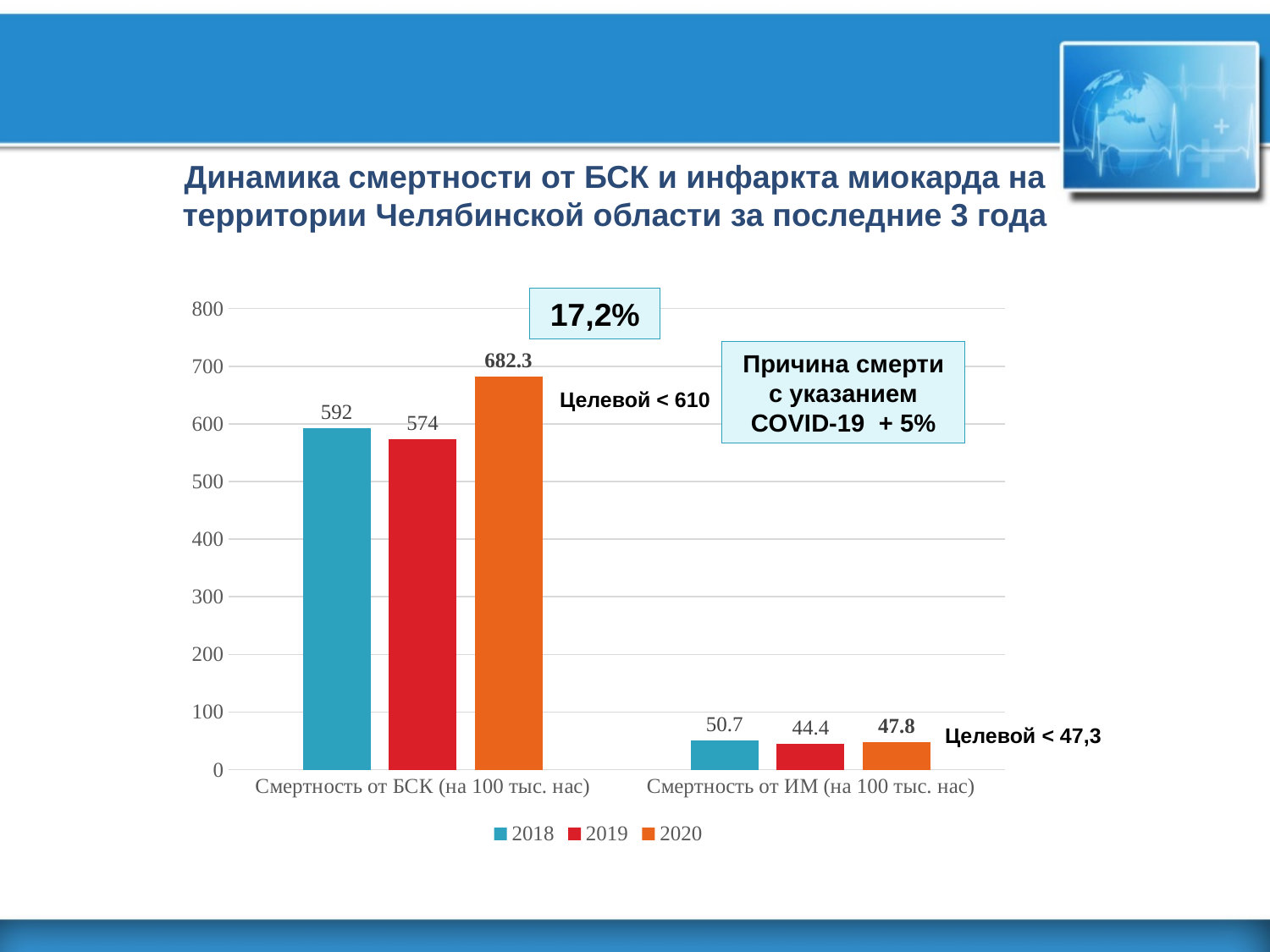
What is the difference between the 2020 and 2019 values in the category "Смертность от БСК (на 100 тыс. нас)"? 108.3 What is the difference between the 2018 and 2020 values in the category "Смертность от ИМ (на 100 тыс. нас)"? 2.9 Which year has the lowest value in the category "Смертность от ИМ (на 100 тыс. нас)"? 2019 What is the value for 2018 in the category "Смертность от БСК (на 100 тыс. нас)"? 592 What is the value for 2020 in the category "Смертность от БСК (на 100 тыс. нас)"? 682.3 Is the 2020 value for "Смертность от БСК (на 100 тыс. нас)" greater or less than 600? greater Which is larger: the 2018 value or the 2019 value in the category "Смертность от БСК (на 100 тыс. нас)"? 2018 How many series does the legend list? 3 What target value (Целевой) is shown next to the "Смертность от ИМ" bars? < 47,3 Which year has the highest value in the category "Смертность от БСК (на 100 тыс. нас)"? 2020 What is the value for 2019 in the category "Смертность от ИМ (на 100 тыс. нас)"? 44.4 What kind of chart is shown on the slide? bar chart